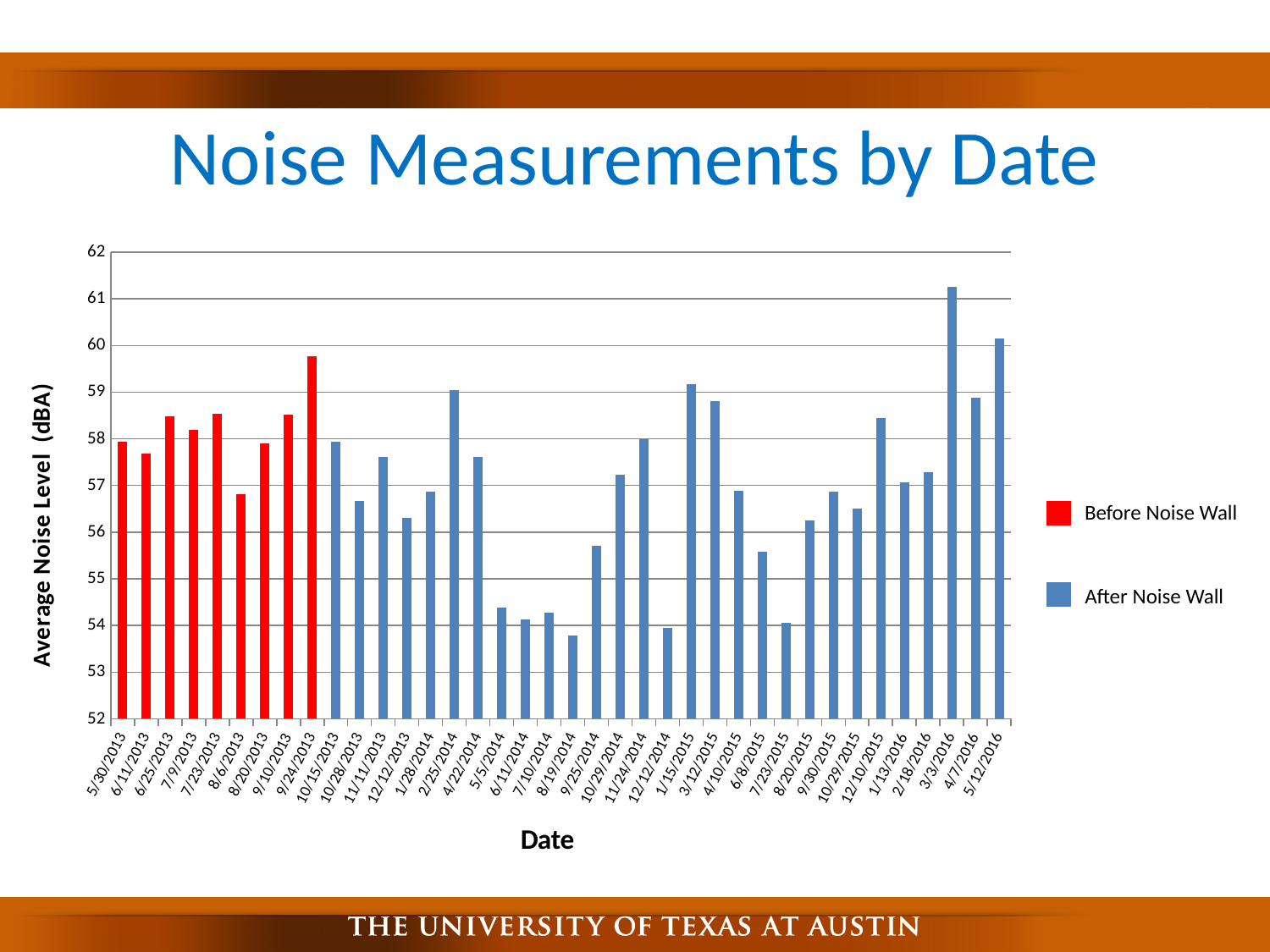
Is the average noise level for 3/3/2016 greater or less than 61? greater Among the 'Before Noise Wall' bars, which date has the lowest average noise level? 8/6/2013 What colour represents the 'After Noise Wall' series in the legend? blue Among the 'Before Noise Wall' bars, which date has the highest average noise level? 9/24/2013 Which date has the highest average noise level? 3/3/2016 Is the average noise level for 5/5/2014 greater or less than 55? less Is the average noise level for 9/24/2013 greater or less than 59? greater What kind of chart is shown on the slide? bar chart Which has a higher average noise level, 5/30/2013 or 8/6/2013? 5/30/2013 How many series does the legend list? 2 How many 'Before Noise Wall' (red) bars are plotted? 9